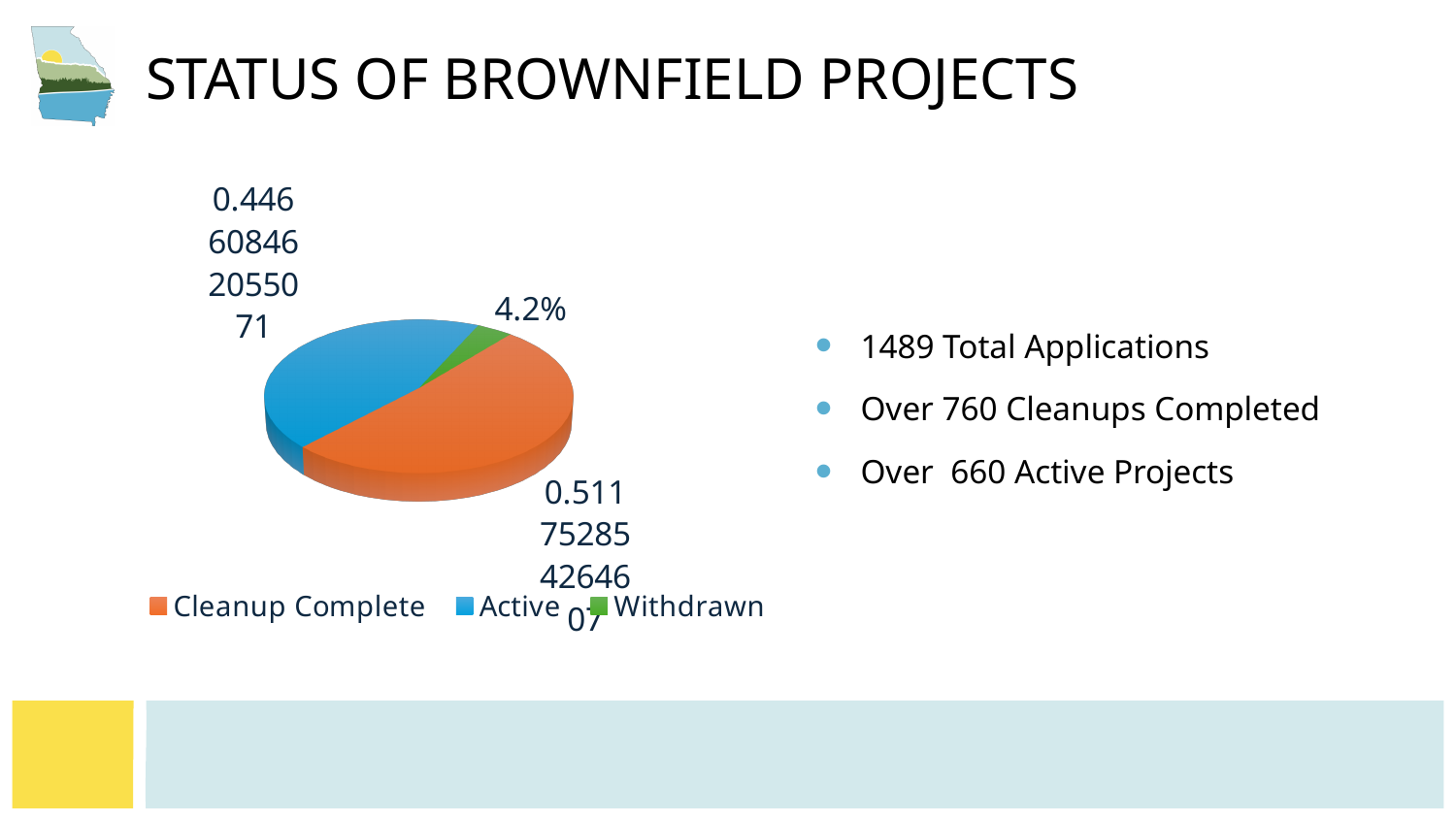
Which category has the smallest slice in the pie chart? Withdrawn What colour is the Active slice in the pie chart? Blue Which slice is larger, Active or Withdrawn? Active What are the three categories listed in the pie chart's legend? Cleanup Complete, Active, Withdrawn How many slices does the pie chart have? 3 What share of the pie is labelled for the Withdrawn slice? 4.2% Which category has the largest slice in the pie chart? Cleanup Complete Which slice is larger, Cleanup Complete or Active? Cleanup Complete What kind of chart is shown on the slide? Pie chart How many entries does the legend of the pie chart list? 3